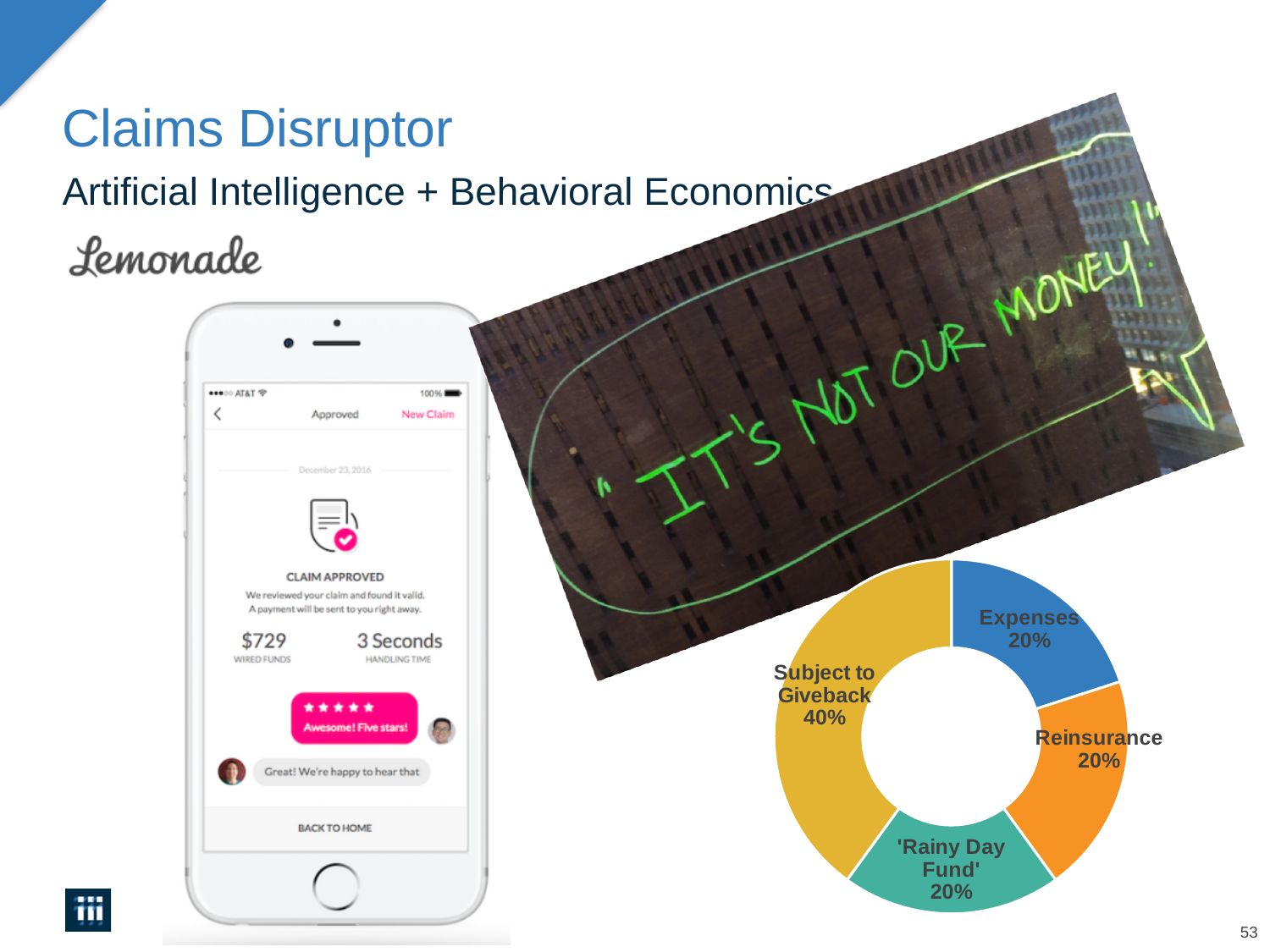
How many slices does the doughnut chart have? 4 Which slice of the doughnut chart is the largest? Subject to Giveback What percentage is shown for the 'Rainy Day Fund' slice? 20% What percentage is shown for Reinsurance in the doughnut chart? 20% What colour is the Expenses slice? blue What colour is the 'Subject to Giveback' slice? yellow What share of the doughnut chart is labelled 'Subject to Giveback'? 40% What kind of chart is shown on the slide? doughnut chart What do the percentages of all four slices add up to? 100% Which is larger in the doughnut chart, Subject to Giveback or Reinsurance? Subject to Giveback What percentage is shown for Expenses in the doughnut chart? 20% By how many percentage points does Subject to Giveback exceed Expenses? 20 percentage points